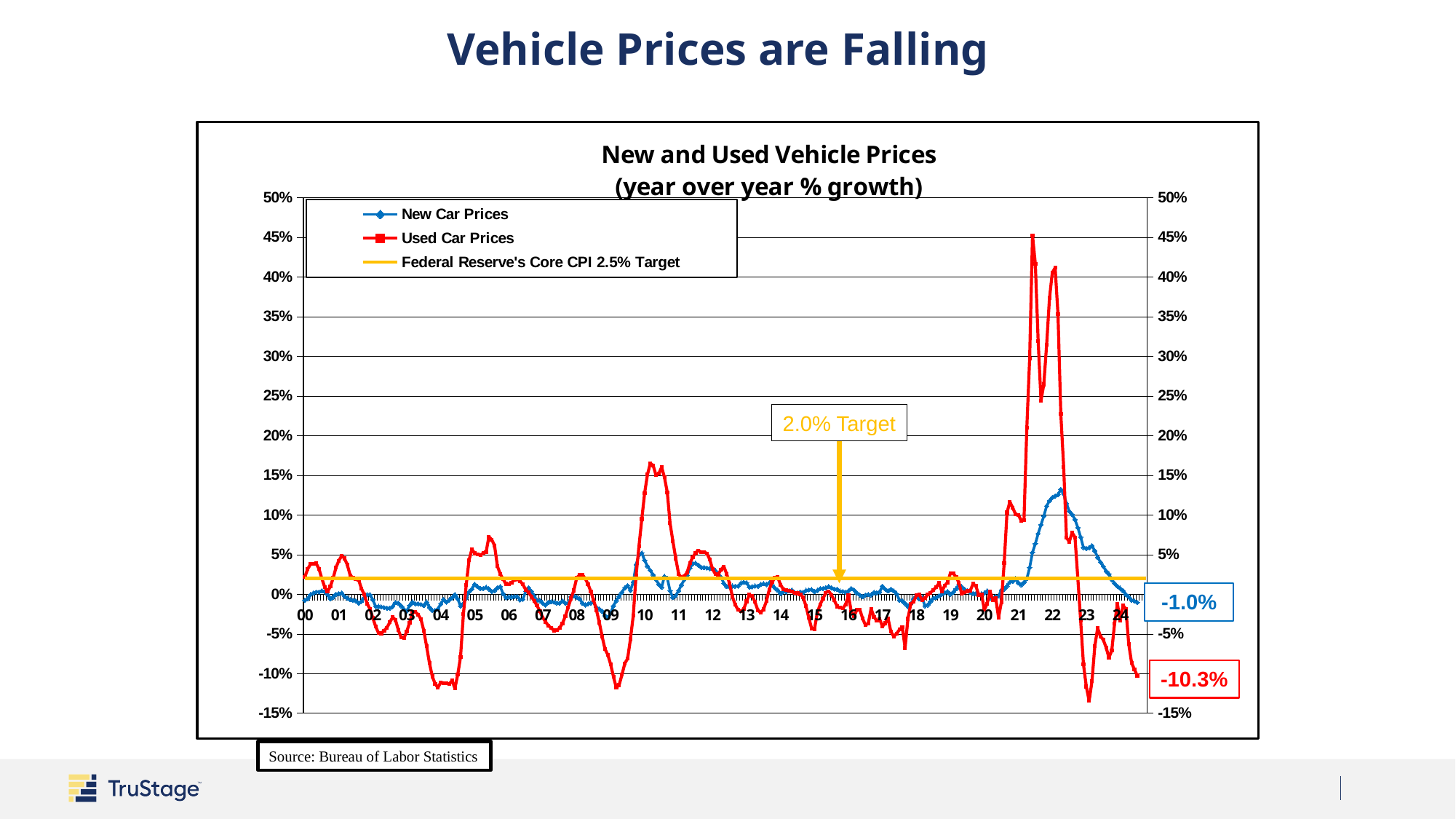
What is the latest labelled value for Used Car Prices? -10.3% Is the peak of Used Car Prices around 2021 greater or less than 40%? greater Which series reaches the highest value on the chart? Used Car Prices How many series does the legend list? 3 From its peak around 2022 to 2024, do New Car Prices rise or fall? Fall What is the title of the chart? New and Used Vehicle Prices (year over year % growth) What kind of chart is shown on the slide? Line chart At the end of the series, which is lower: New Car Prices or Used Car Prices? Used Car Prices Is the peak of New Car Prices around 2022 greater or less than 10%? greater What is the difference between the latest labelled New Car Prices value (-1.0%) and the latest labelled Used Car Prices value (-10.3%)? 9.3 percentage points Is the lowest point of Used Car Prices around 2023 greater or less than -10%? less What is the latest labelled value for New Car Prices? -1.0%